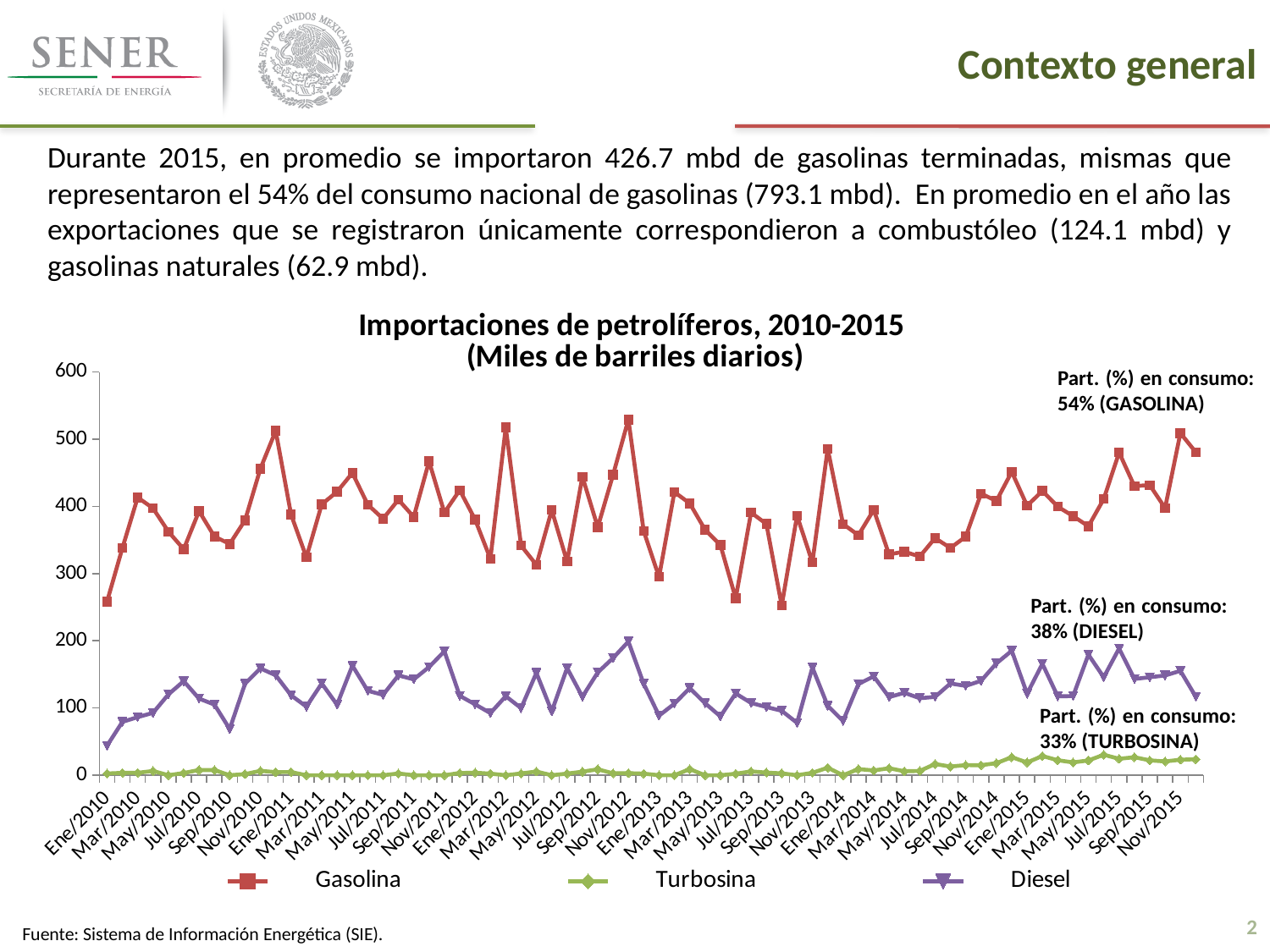
Is the Turbosina value for Nov/2015 greater or less than 100? less Is the Gasolina value for Nov/2012 greater or less than 500? greater According to the annotation on the chart, what share of consumption does Gasolina represent? 54% Is the Gasolina value for Ene/2010 greater or less than 300? less What kind of chart is shown on the slide? line chart Do the Gasolina values rise or fall from Ene/2010 to Mar/2010? rise What is the title of the chart? Importaciones de petrolíferos, 2010-2015 (Miles de barriles diarios) Which series has the lowest values throughout the chart? Turbosina Which series has the highest values throughout the chart? Gasolina Which is larger in Ene/2010, the Gasolina value or the Diesel value? Gasolina How many series does the chart legend list? 3